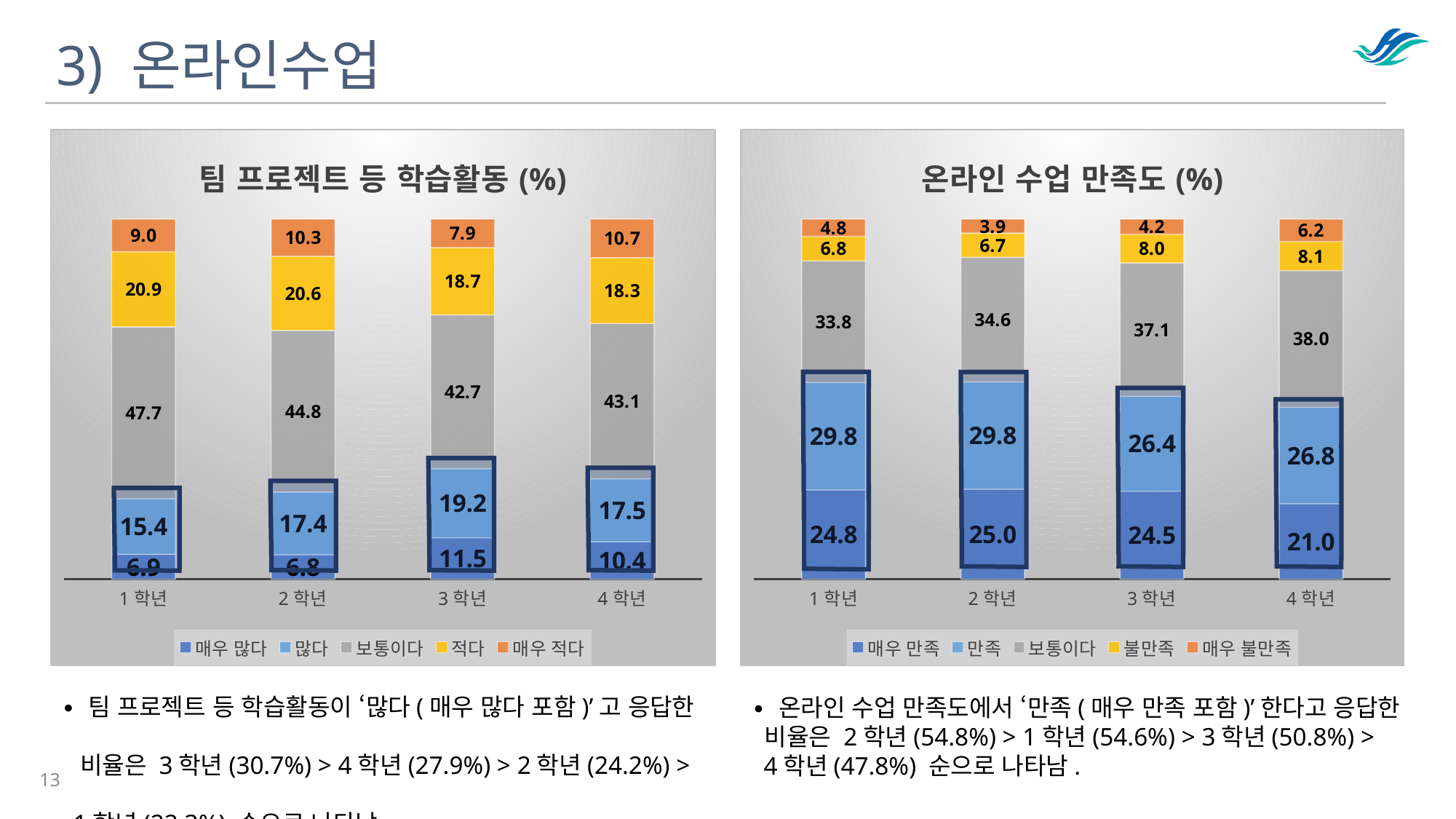
In the chart titled '팀 프로젝트 등 학습활동 (%)', how many series does the legend list? 5 In the chart titled '팀 프로젝트 등 학습활동 (%)', what is the value of '보통이다' for 1 학년? 47.7 In the chart titled '온라인 수업 만족도 (%)', is the '만족' value larger for 1 학년 or 3 학년? 1 학년 In the chart titled '온라인 수업 만족도 (%)', which grade has the lowest value for '매우 만족'? 4 학년 What type of chart is the chart titled '온라인 수업 만족도 (%)'? Stacked bar chart In the chart titled '온라인 수업 만족도 (%)', what is the value of '보통이다' for 4 학년? 38.0 In the chart titled '온라인 수업 만족도 (%)', what is the value of '매우 불만족' for 2 학년? 3.9 In the chart titled '팀 프로젝트 등 학습활동 (%)', what is the difference between the '많다' values for 3 학년 and 1 학년? 3.8 In the chart titled '팀 프로젝트 등 학습활동 (%)', which grade has the highest value for '매우 적다'? 4 학년 In the chart titled '팀 프로젝트 등 학습활동 (%)', what is the value of '매우 많다' for 3 학년? 11.5 In the chart titled '온라인 수업 만족도 (%)', what is the combined value of '매우 만족' and '만족' for 2 학년? 54.8 In the chart titled '온라인 수업 만족도 (%)', how many grade categories are shown on the x axis? 4